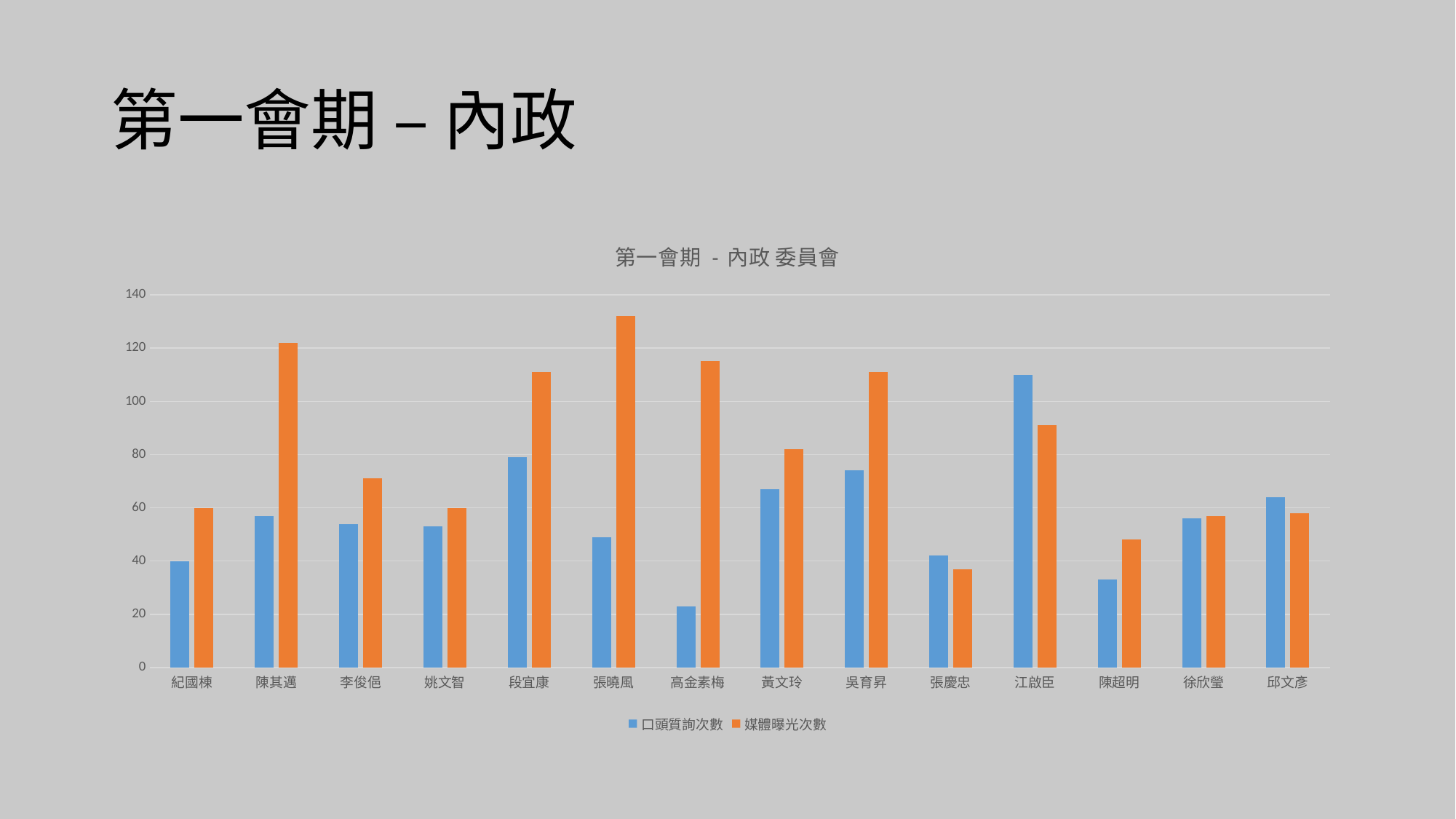
Which category has the highest 口頭質詢次數 value? 江啟臣 How many series does the legend list? 2 What is the title of the chart? 第一會期 - 內政 委員會 How many categories (legislators) are shown on the x axis? 14 Is the 口頭質詢次數 value for 高金素梅 greater or less than 40? less Is the 口頭質詢次數 value for 江啟臣 greater or less than 100? greater What kind of chart is shown on the slide? bar chart Which category has the lowest 口頭質詢次數 value? 高金素梅 Which category has the highest 媒體曝光次數 value? 張曉風 Is the 媒體曝光次數 value for 張曉風 greater or less than 120? greater Which category has the lowest 媒體曝光次數 value? 張慶忠 For 江啟臣, which is larger: 口頭質詢次數 or 媒體曝光次數? 口頭質詢次數